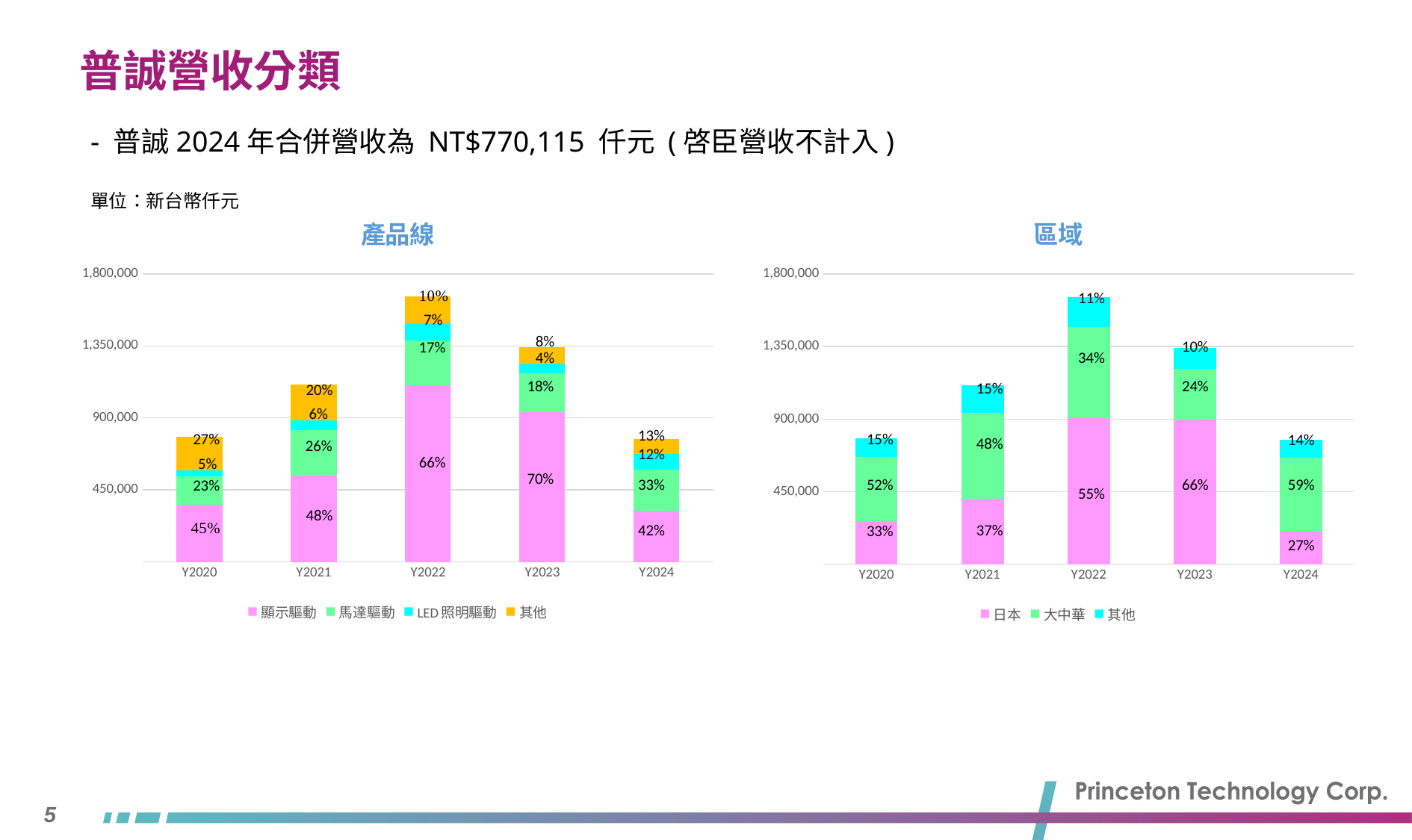
In the 區域 chart, what percentage does 大中華 account for in Y2024? 59% In the 區域 chart, which year has the shortest stacked bar? Y2024 In the 區域 chart, is the total bar for Y2024 greater or less than 900,000? less In the 產品線 chart, by how many percentage points did the 顯示驅動 share fall from Y2023 to Y2024? 28 percentage points How many series does the legend of the 產品線 chart list? 4 In the 區域 chart, what percentage does 日本 account for in Y2022? 55% In the 產品線 chart, which year has the tallest stacked bar? Y2022 In the 產品線 chart, is the total bar for Y2022 greater or less than 1,350,000? greater In the 產品線 chart, what percentage does 其他 account for in Y2020? 27% What kind of chart is the 區域 chart? Stacked bar chart How many years are shown on the x axis of the 區域 chart? 5 In the 產品線 chart, what percentage does 顯示驅動 account for in Y2023? 70%